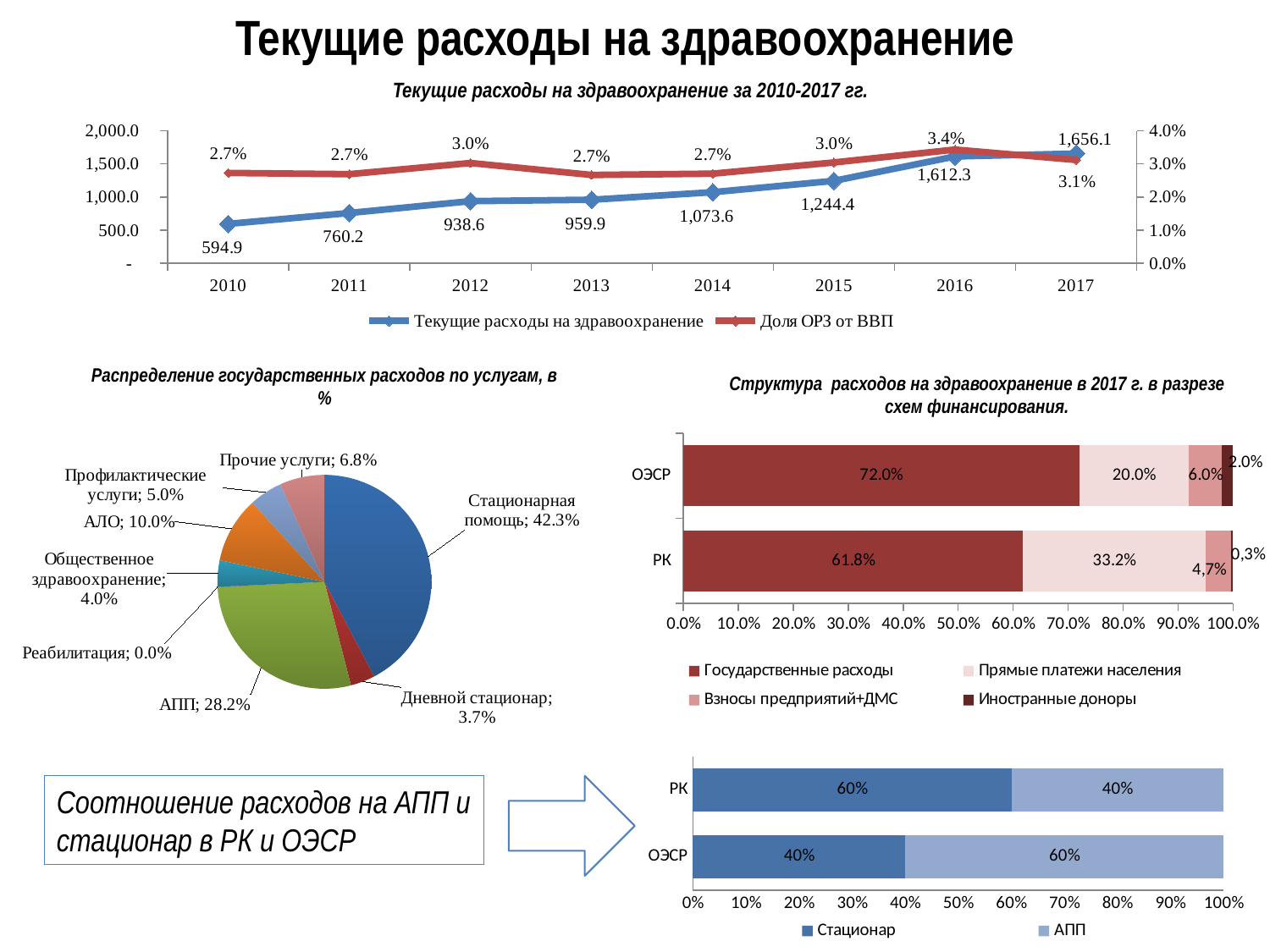
In the line chart 'Текущие расходы на здравоохранение за 2010-2017 гг.', by how much did 'Текущие расходы на здравоохранение' increase from 2010 to 2017? 1,061.2 In the chart 'Структура расходов на здравоохранение в 2017 г. в разрезе схем финансирования', what is the difference between 'Государственные расходы' for ОЭСР and for РК? 10.2% In the line chart 'Текущие расходы на здравоохранение за 2010-2017 гг.', what is the value of 'Текущие расходы на здравоохранение' for 2014? 1,073.6 In the chart 'Структура расходов на здравоохранение в 2017 г. в разрезе схем финансирования', what is the value of 'Прямые платежи населения' for РК? 33.2% In the line chart 'Текущие расходы на здравоохранение за 2010-2017 гг.', does 'Текущие расходы на здравоохранение' rise or fall from 2010 to 2017? rise In the line chart 'Текущие расходы на здравоохранение за 2010-2017 гг.', what is the value of 'Доля ОРЗ от ВВП' for 2016? 3.4% In the bottom-right chart with the legend 'Стационар' and 'АПП', what is the value of 'Стационар' for РК? 60% In the pie chart 'Распределение государственных расходов по услугам, в %', which category has the largest share? Стационарная помощь In the pie chart 'Распределение государственных расходов по услугам, в %', what is the share of 'АПП'? 28.2% In the pie chart 'Распределение государственных расходов по услугам, в %', how many categories are shown? 8 What kind of chart is the bottom-right chart with the legend 'Стационар' and 'АПП'? bar chart In the line chart 'Текущие расходы на здравоохранение за 2010-2017 гг.', how many series does the legend list? 2